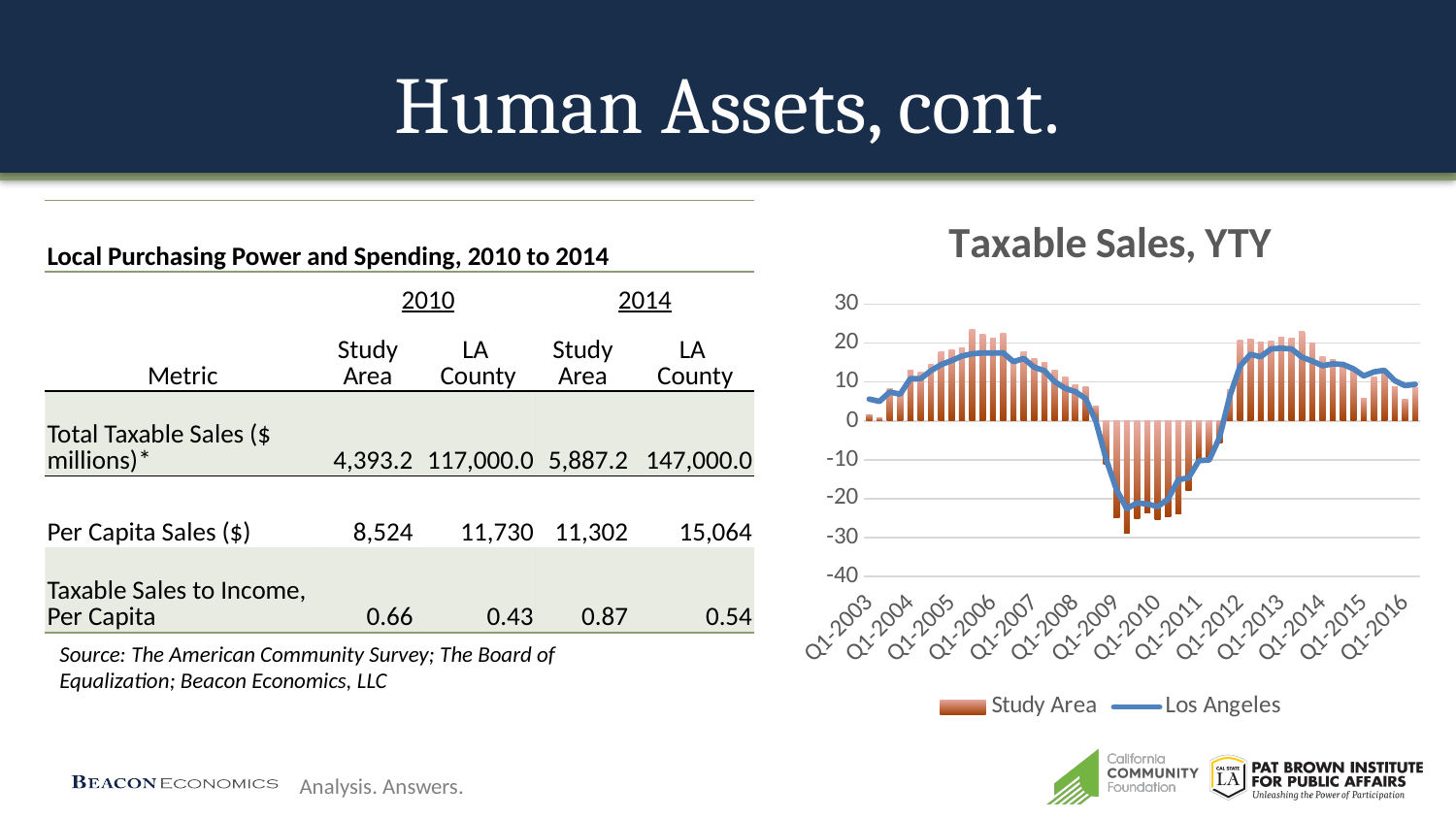
How many year labels are shown on the x axis of the Taxable Sales, YTY chart? 14 What kind of chart is the Taxable Sales, YTY chart? A combined bar and line chart In the Taxable Sales, YTY chart, is the Study Area value at Q1-2003 greater or less than 10? less In the Taxable Sales, YTY chart, is the Los Angeles value at Q1-2003 greater or less than 10? less Which series in the Taxable Sales, YTY chart is drawn as bars? Study Area How many series does the legend of the Taxable Sales, YTY chart list? 2 Which series in the Taxable Sales, YTY chart is drawn as a line? Los Angeles In the Taxable Sales, YTY chart, is the Study Area value at Q1-2006 greater or less than 10? greater In the Taxable Sales, YTY chart, do the Los Angeles values rise or fall between Q1-2010 and Q1-2012? rise In the Taxable Sales, YTY chart, do the Los Angeles values rise or fall between Q1-2007 and Q1-2009? fall